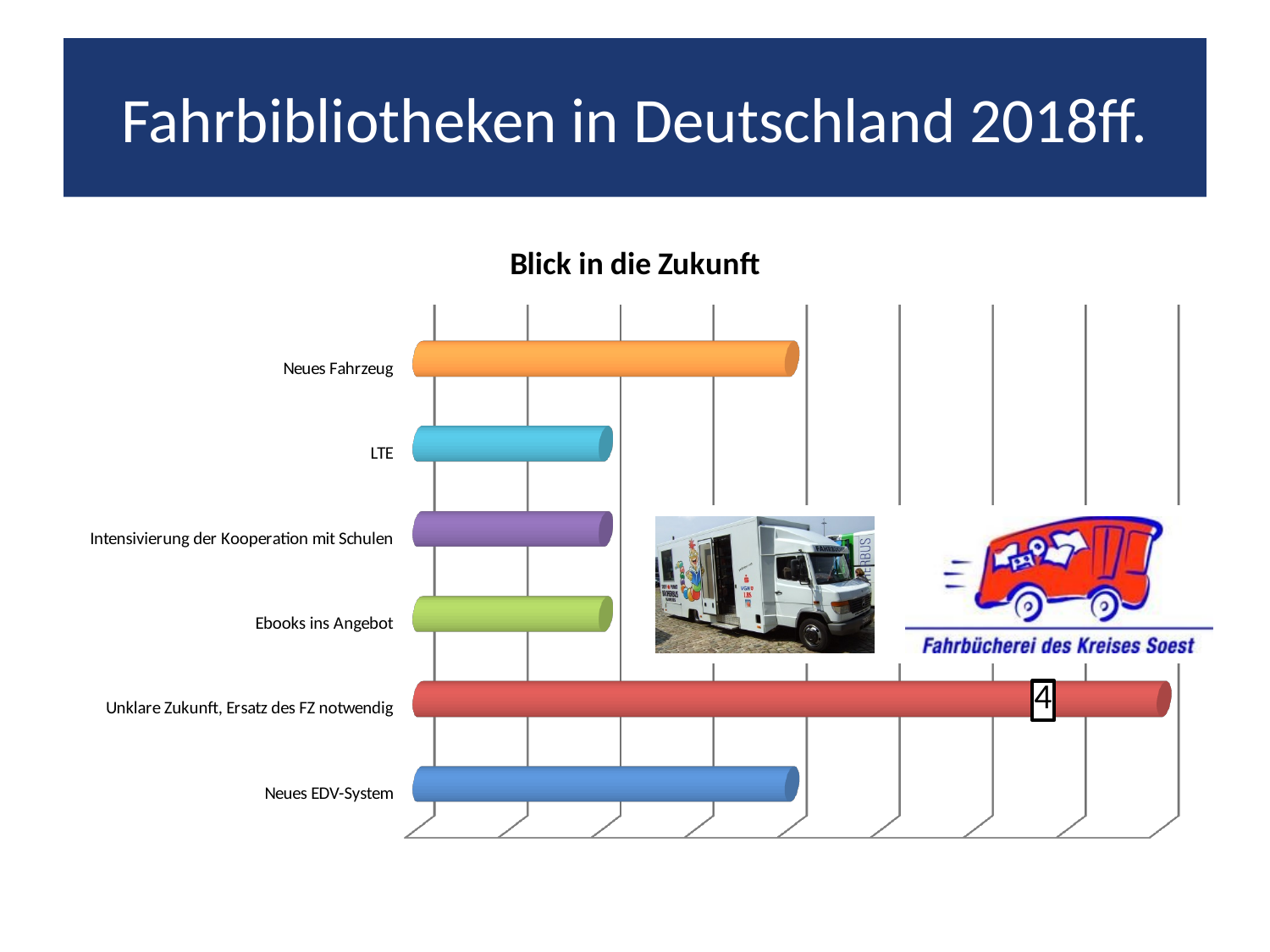
What is the title of the chart? Blick in die Zukunft What colour is the bar for Neues Fahrzeug? orange Which bar is longer: Neues EDV-System or Ebooks ins Angebot? Neues EDV-System Which category has the longest bar in the chart? Unklare Zukunft, Ersatz des FZ notwendig What kind of chart is shown on the slide? bar chart How many categories does the chart show? 6 Which bar is longer: LTE or Unklare Zukunft, Ersatz des FZ notwendig? Unklare Zukunft, Ersatz des FZ notwendig Which bar is longer: Unklare Zukunft, Ersatz des FZ notwendig or Neues EDV-System? Unklare Zukunft, Ersatz des FZ notwendig